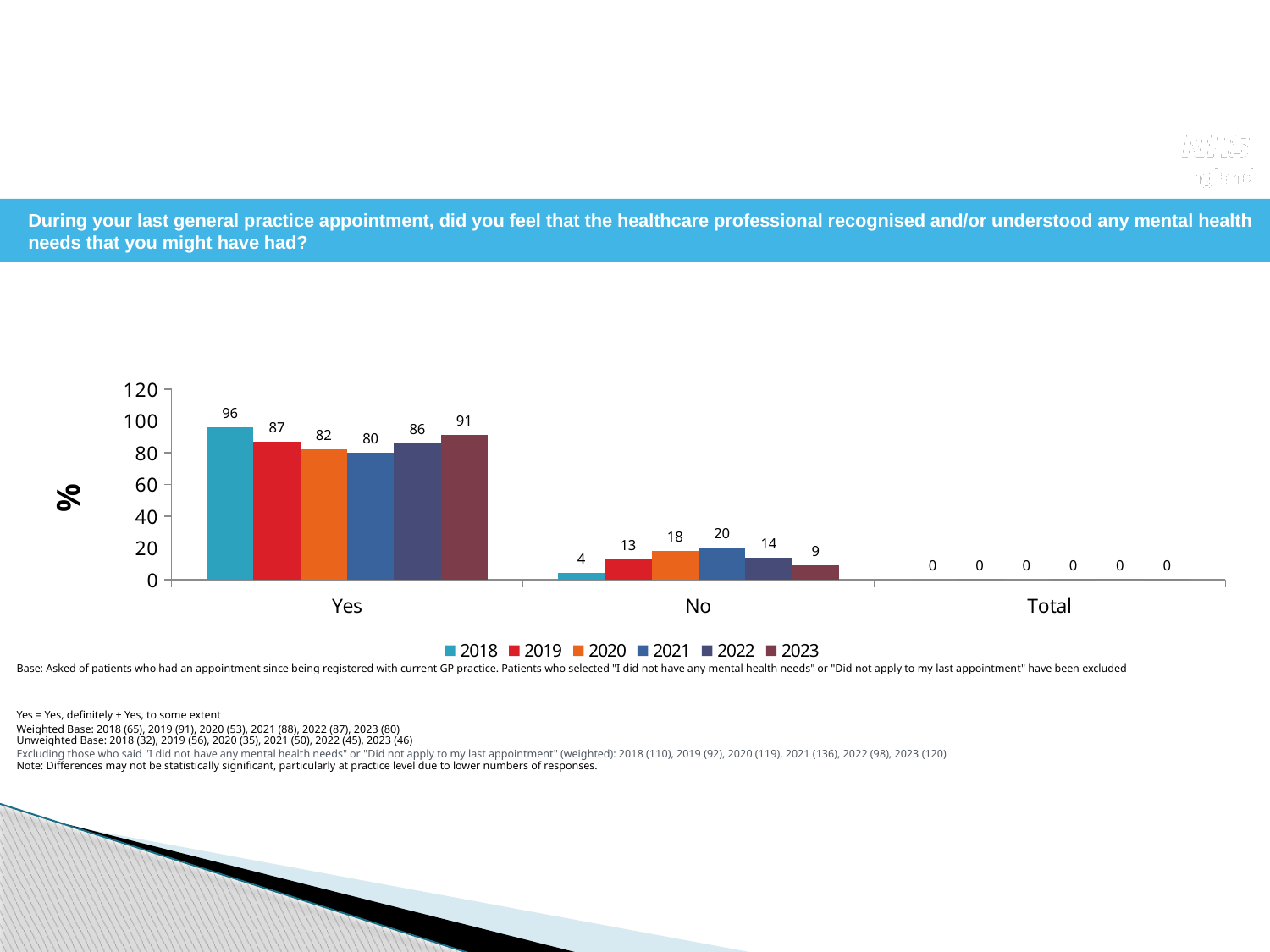
What is the value for 2022 in the Total category? 0 How many categories are shown on the x axis? 3 What is the value for 2021 in the Yes category? 80 What is the difference between the 2018 and 2021 values in the Yes category? 16 Which is larger in the No category: the value for 2020 or the value for 2022? 2020 Which year has the lowest value in the No category? 2018 How many series does the legend list? 6 What kind of chart is shown on the slide? Bar chart Which year has the highest value in the Yes category? 2018 What is the value for 2018 in the Yes category? 96 What is the label on the y axis? % What is the value for 2023 in the No category? 9